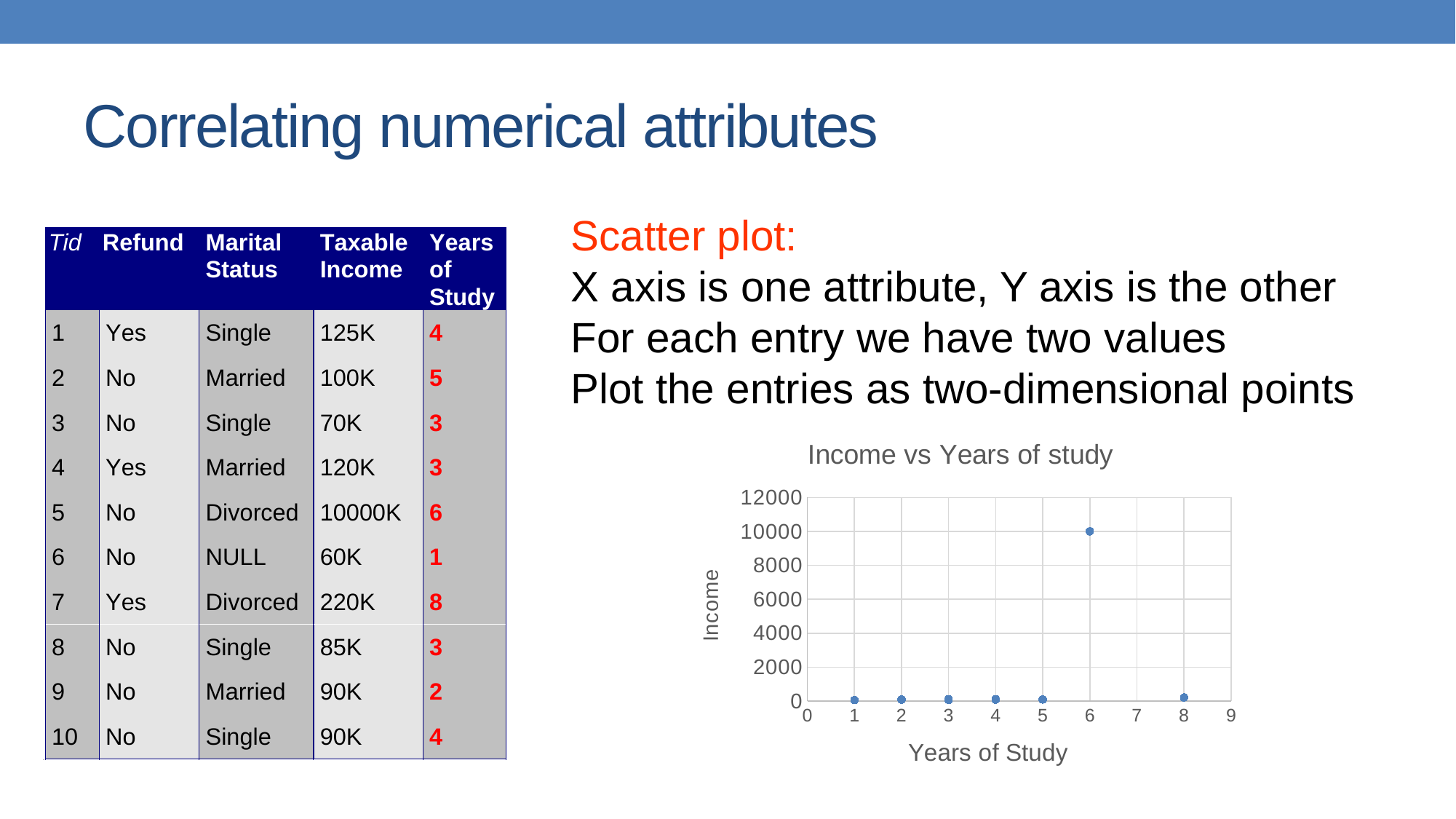
What is the label of the x axis of the chart? Years of Study Which point has the larger Income: the one at 6 Years of Study or the one at 2 Years of Study? 6 Years of Study Which point has the larger Income: the one at 6 Years of Study or the one at 8 Years of Study? 6 Years of Study What is the highest value shown on the y axis of the chart? 12000 Is the Income value for the point at 1 Year of Study greater or less than 4000? less Is the Income value for the point at 6 Years of Study greater or less than 8000? greater At which value of Years of Study does the chart show the highest Income? 6 Is the Income value for the point at 8 Years of Study greater or less than 2000? less What is the title of the chart? Income vs Years of study What kind of chart is shown on the slide? scatter plot